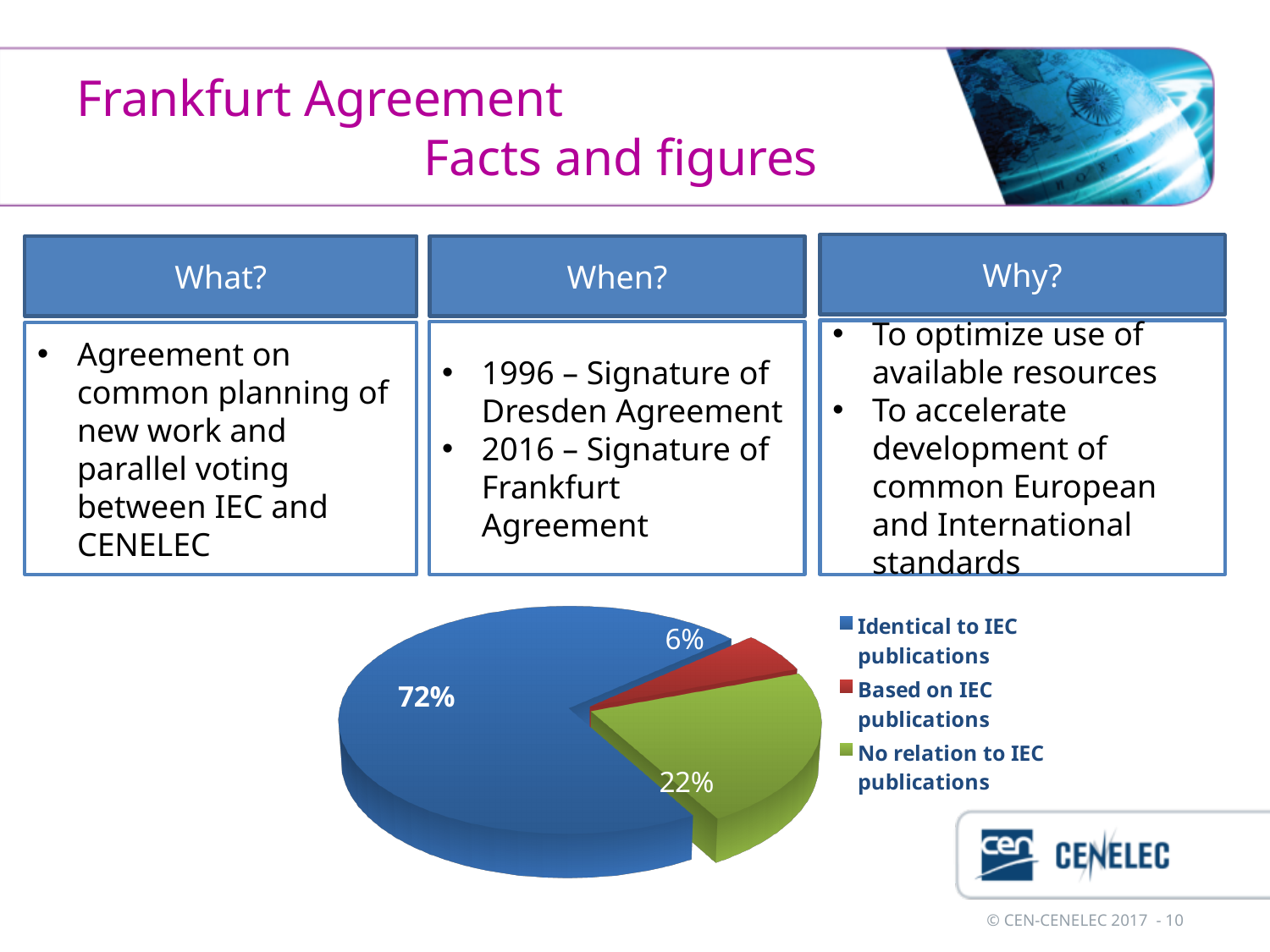
What share of the pie is labelled "Based on IEC publications"? 6% What share of the pie is labelled "Identical to IEC publications"? 72% What is the difference in percentage points between the "Identical to IEC publications" slice and the "No relation to IEC publications" slice? 50 How many entries does the legend list? 3 How many slices does the pie chart have? 3 Which category has the smallest slice of the pie? Based on IEC publications What colour is the slice for "No relation to IEC publications"? green Which category has the largest slice of the pie? Identical to IEC publications What share of the pie is labelled "No relation to IEC publications"? 22% What kind of chart is shown on the slide? pie chart Which is larger: the "No relation to IEC publications" slice or the "Based on IEC publications" slice? No relation to IEC publications What colour is the slice for "Identical to IEC publications"? blue